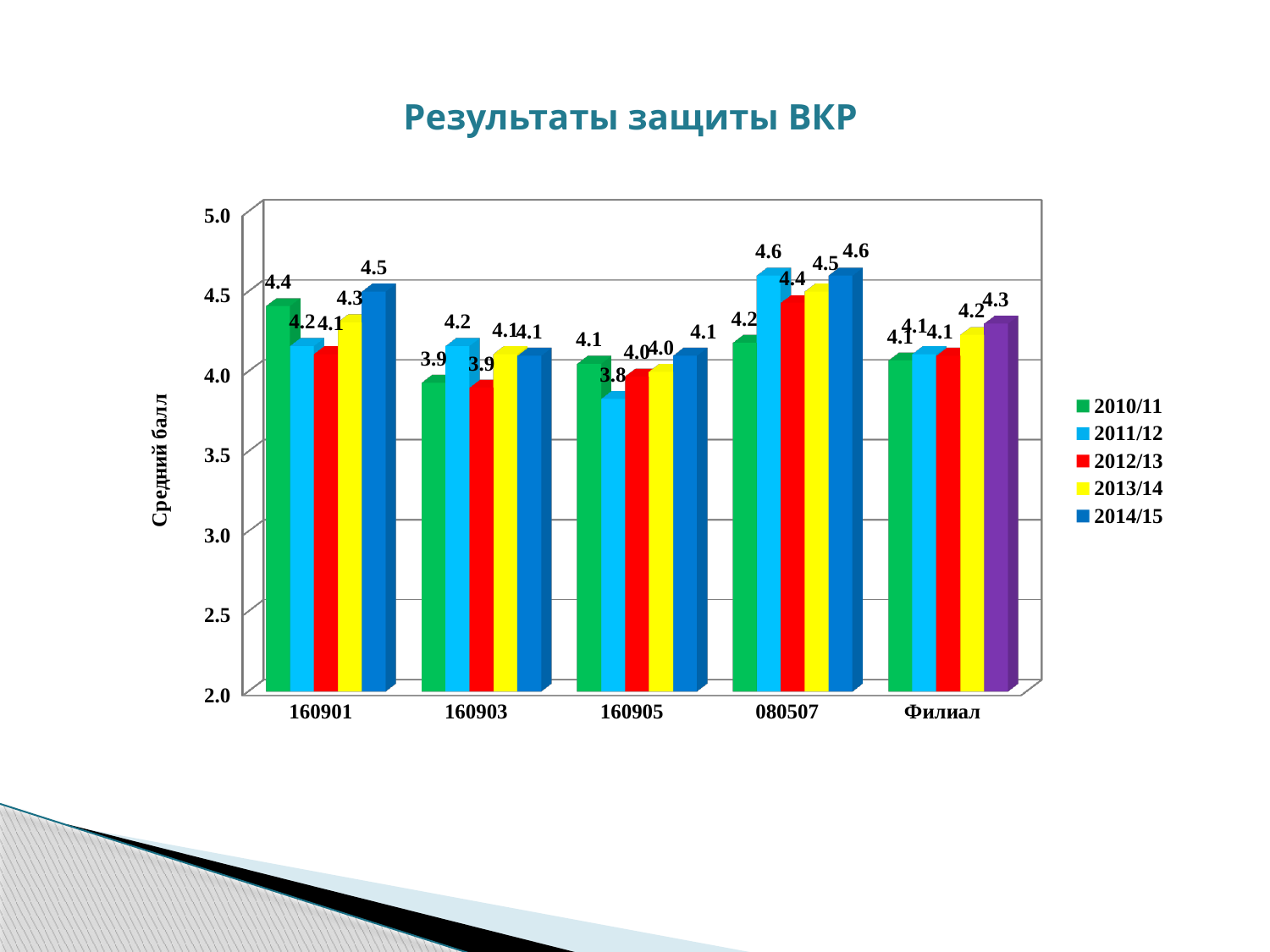
What is the difference between the 2011/12 values for 080507 and 160905? 0.8 Which category has the lowest value in the 2011/12 series? 160905 What is the value for 160901 in the 2014/15 series? 4.5 What is the value for 160905 in the 2011/12 series? 3.8 Which category has the larger 2010/11 value, 160901 or 160903? 160901 What kind of chart is shown on the slide? Bar chart What is the value for Филиал in the 2013/14 series? 4.2 What is the title of the vertical axis? Средний балл How many categories are shown on the x axis? 5 Which category has the highest value in the 2014/15 series? 080507 What is the value for 080507 in the 2011/12 series? 4.6 How many series does the legend list? 5